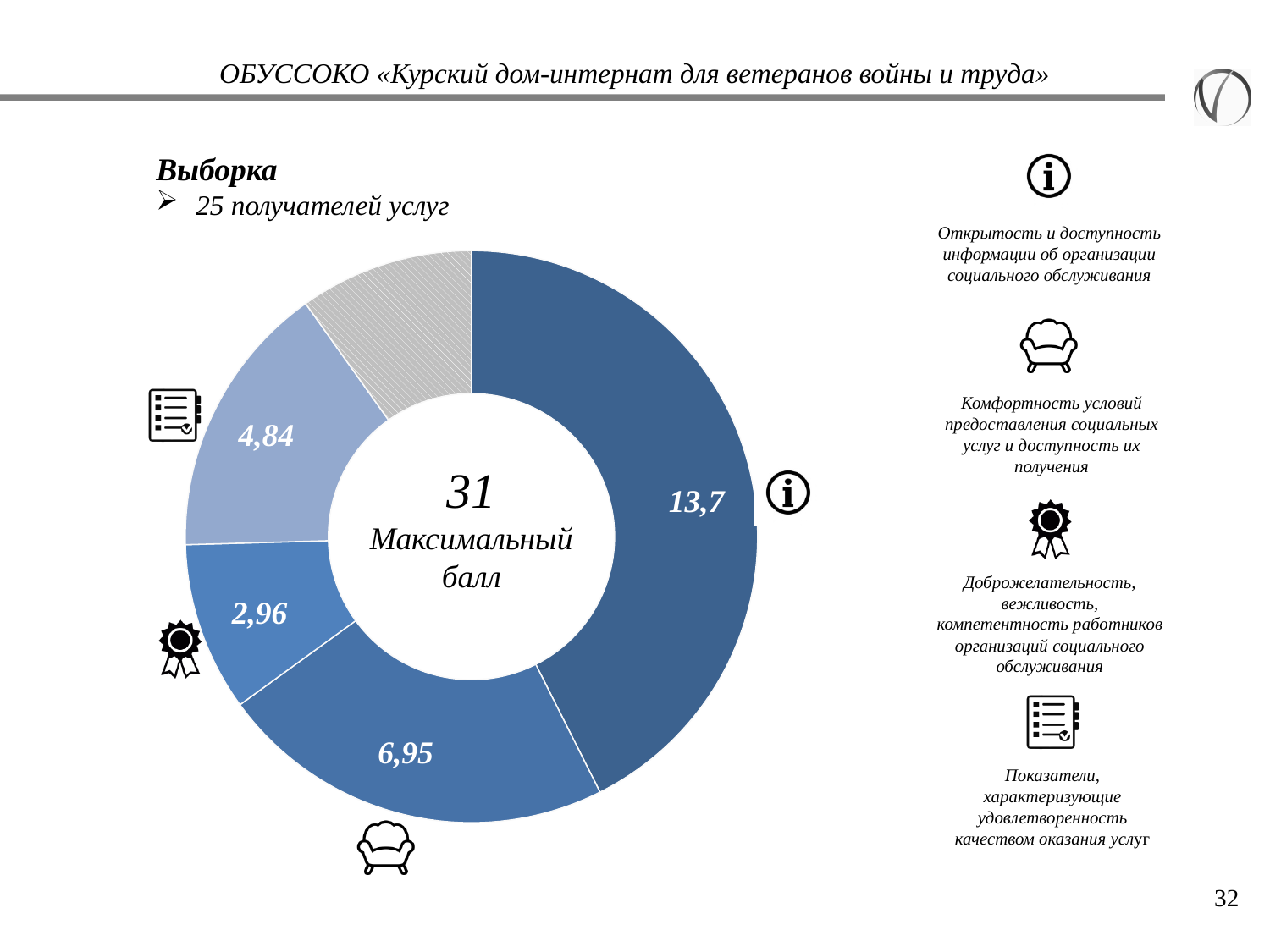
Which labeled segment of the donut chart has the lowest value? 2,96 (Доброжелательность, вежливость, компетентность работников) Which labeled segment of the donut chart has the highest value? 13,7 (Открытость и доступность информации) What value is shown for the segment marked with the information icon (Открытость и доступность информации об организации социального обслуживания)? 13,7 What is the difference between the value for Показатели удовлетворенности (4,84) and the value for Доброжелательность (2,96)? 1,88 Which is larger: the value for Комфортность условий or the value for Показатели удовлетворенности? Комфортность условий (6,95) What value is shown for the segment marked with the checklist icon (Показатели, характеризующие удовлетворенность качеством оказания услуг)? 4,84 What number is shown in the centre of the donut chart as the maximum score (Максимальный балл)? 31 What value is shown for the segment marked with the armchair icon (Комфортность условий предоставления социальных услуг)? 6,95 How many segments of the donut chart have a printed value label? 4 What type of chart is shown on the slide? Donut (pie) chart What is the difference between the largest labeled value (13,7) and the value for Комфортность условий (6,95)? 6,75 What value is shown for the segment marked with the medal icon (Доброжелательность, вежливость, компетентность работников)? 2,96